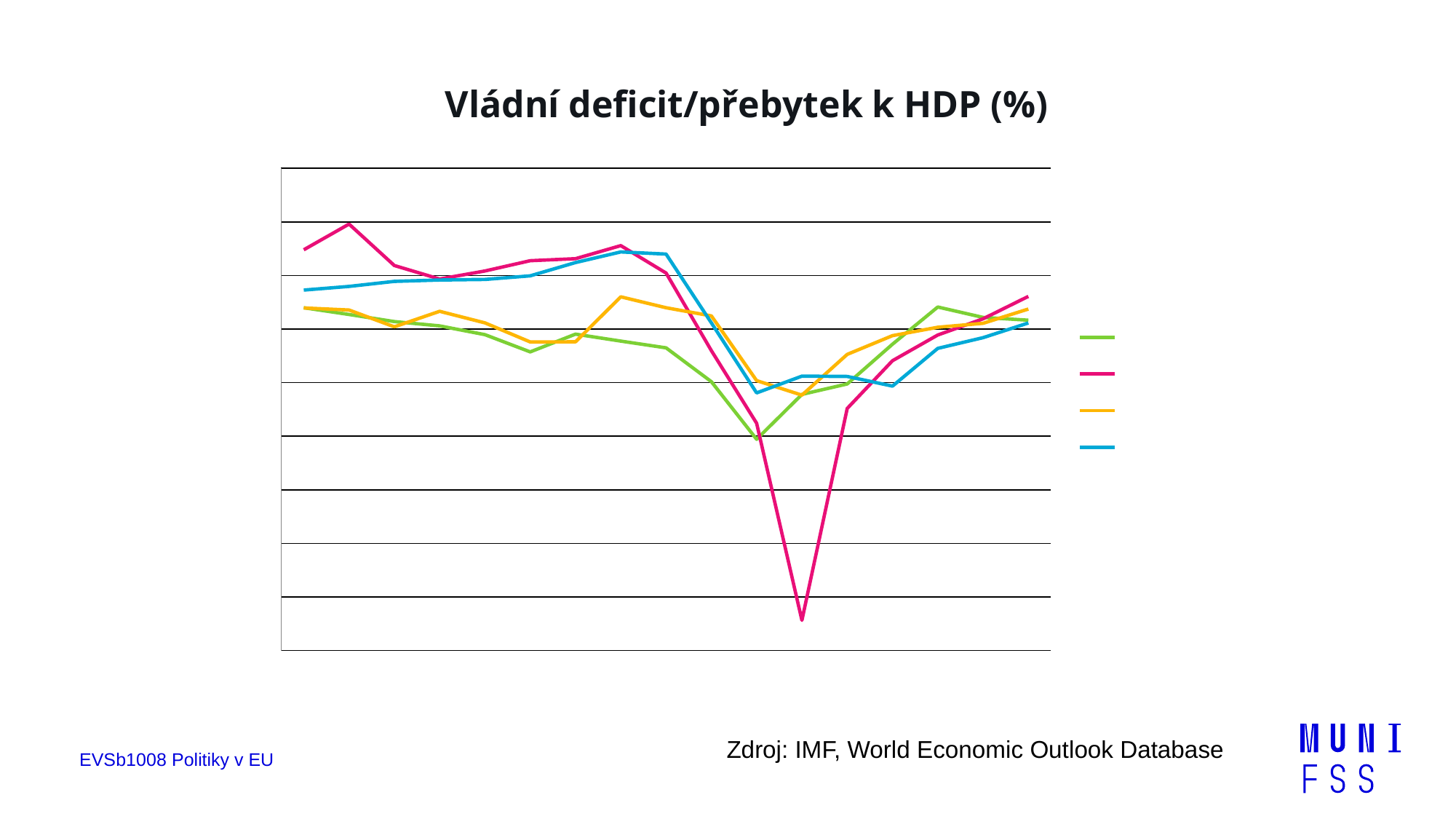
What kind of chart is shown on the slide? line chart What is the title of the chart? Vládní deficit/přebytek k HDP (%) What source is cited below the chart? IMF, World Economic Outlook Database Which coloured line drops to the lowest point on the chart? the pink line How many series does the legend list? 4